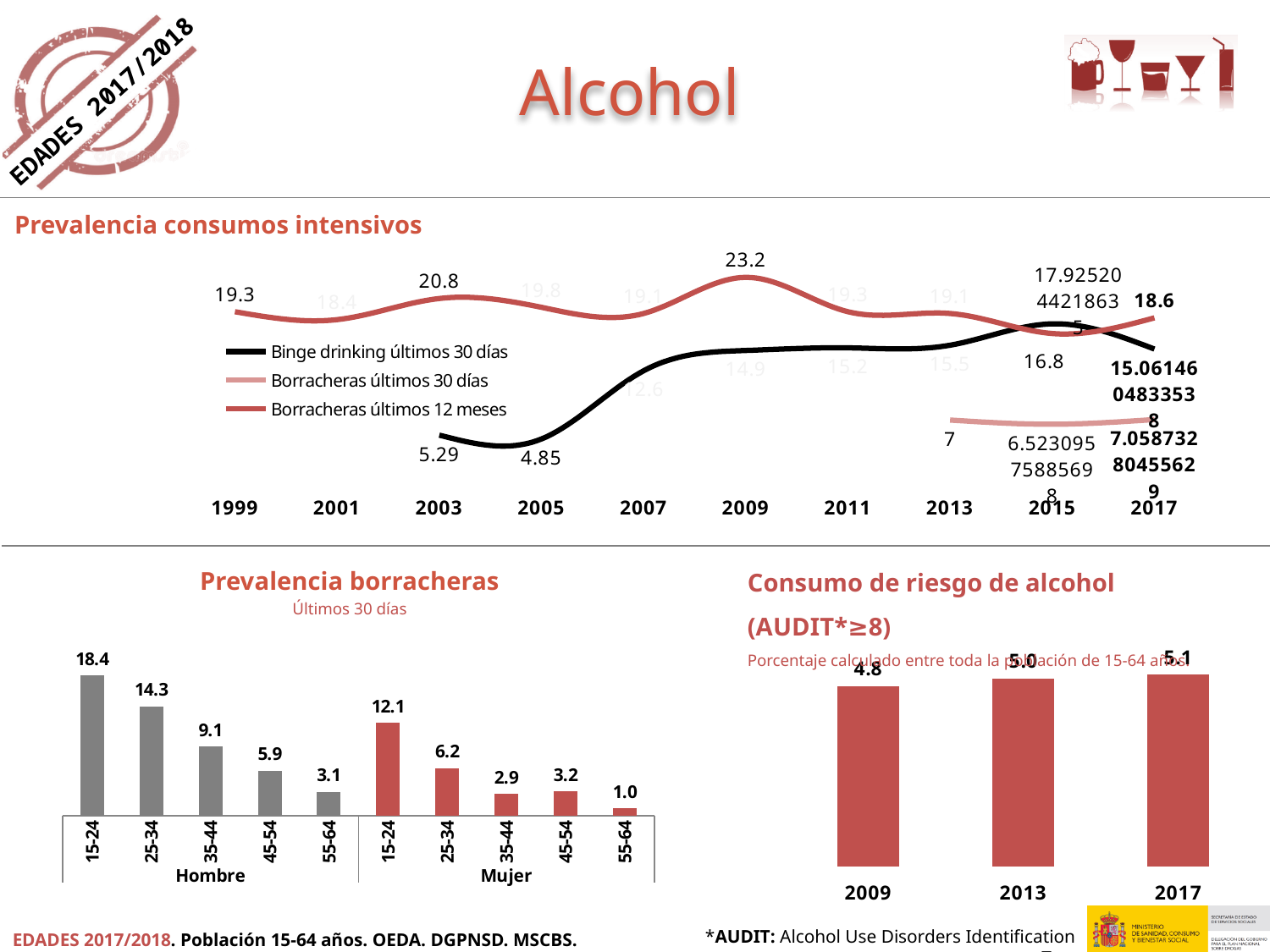
In the 'Prevalencia borracheras' chart, which group has the lowest value? Mujer 55-64 In the 'Prevalencia consumos intensivos' chart, how many series does the legend list? 3 In the 'Prevalencia consumos intensivos' chart, what is the difference between the 'Borracheras últimos 12 meses' values in 2003 and 1999? 1.5 In the 'Prevalencia consumos intensivos' chart, what is the value for 'Binge drinking últimos 30 días' in 2005? 4.85 In the 'Prevalencia borracheras' chart, how many bars are plotted? 10 In the 'Prevalencia borracheras' chart, what is the difference between Hombre 25-34 and Mujer 25-34? 8.1 In the 'Consumo de riesgo de alcohol (AUDIT*≥8)' chart, do the values rise or fall from 2009 to 2017? rise In the 'Prevalencia borracheras' chart, what is the value for Hombre aged 15-24? 18.4 In the 'Consumo de riesgo de alcohol (AUDIT*≥8)' chart, what is the value for 2013? 5.0 In the 'Prevalencia consumos intensivos' chart, what is the value for 'Borracheras últimos 12 meses' in 2009? 23.2 In the 'Prevalencia borracheras' chart, which is larger: Hombre 35-44 or Mujer 25-34? Hombre 35-44 In the 'Prevalencia consumos intensivos' chart, in which year does 'Borracheras últimos 12 meses' reach its highest value? 2009